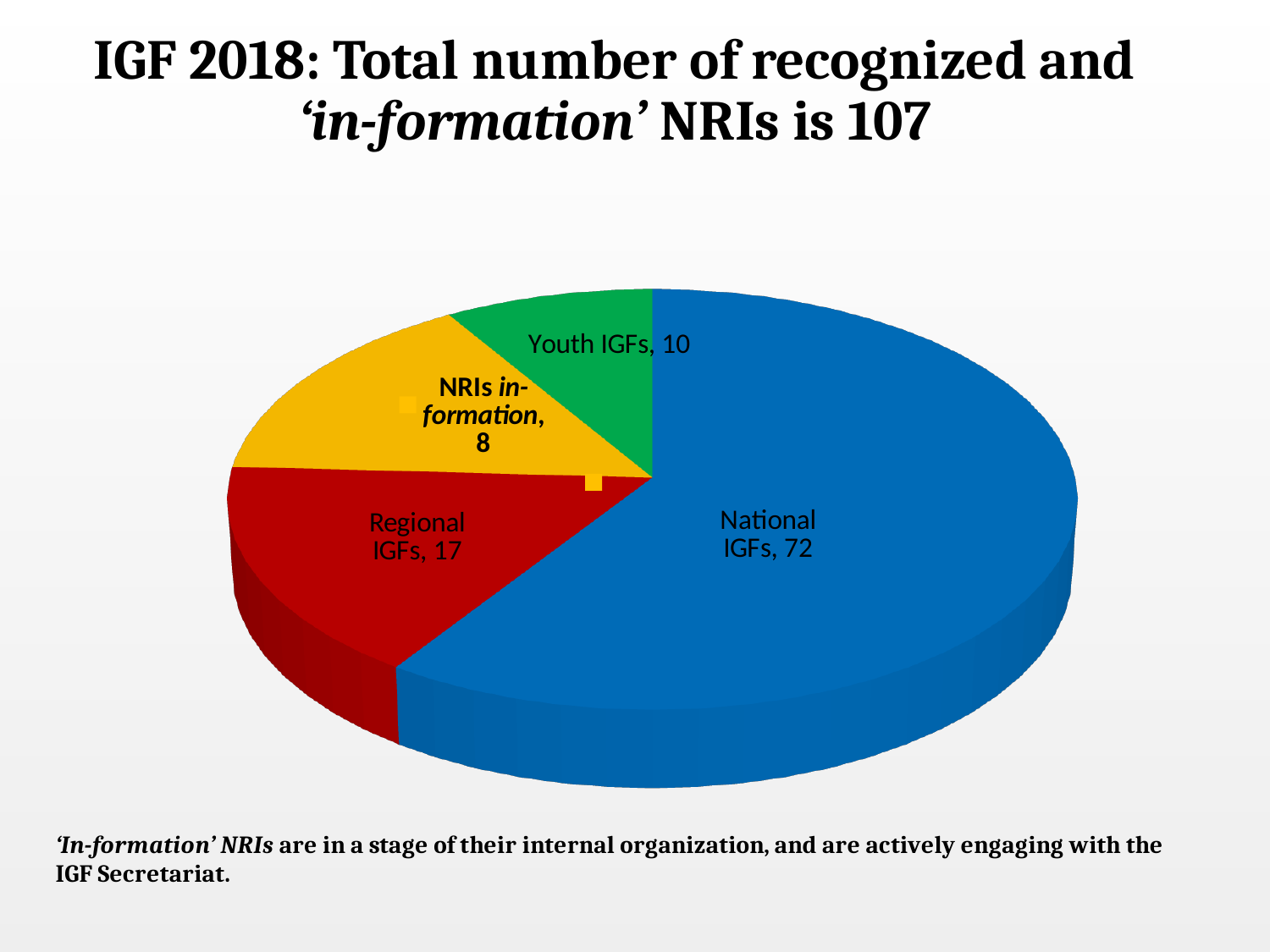
What is the value for Youth IGFs? 10 What is the value for Regional IGFs? 17 How many National IGFs are shown in the pie chart? 72 What is the value for NRIs in-formation? 8 Which category has the largest slice of the pie? National IGFs What is the difference between the number of National IGFs and Regional IGFs? 55 What colour is the National IGFs slice? Blue What is the total of all slices in the pie chart? 107 How many slices does the pie chart have? 4 What kind of chart is shown on the slide? Pie chart